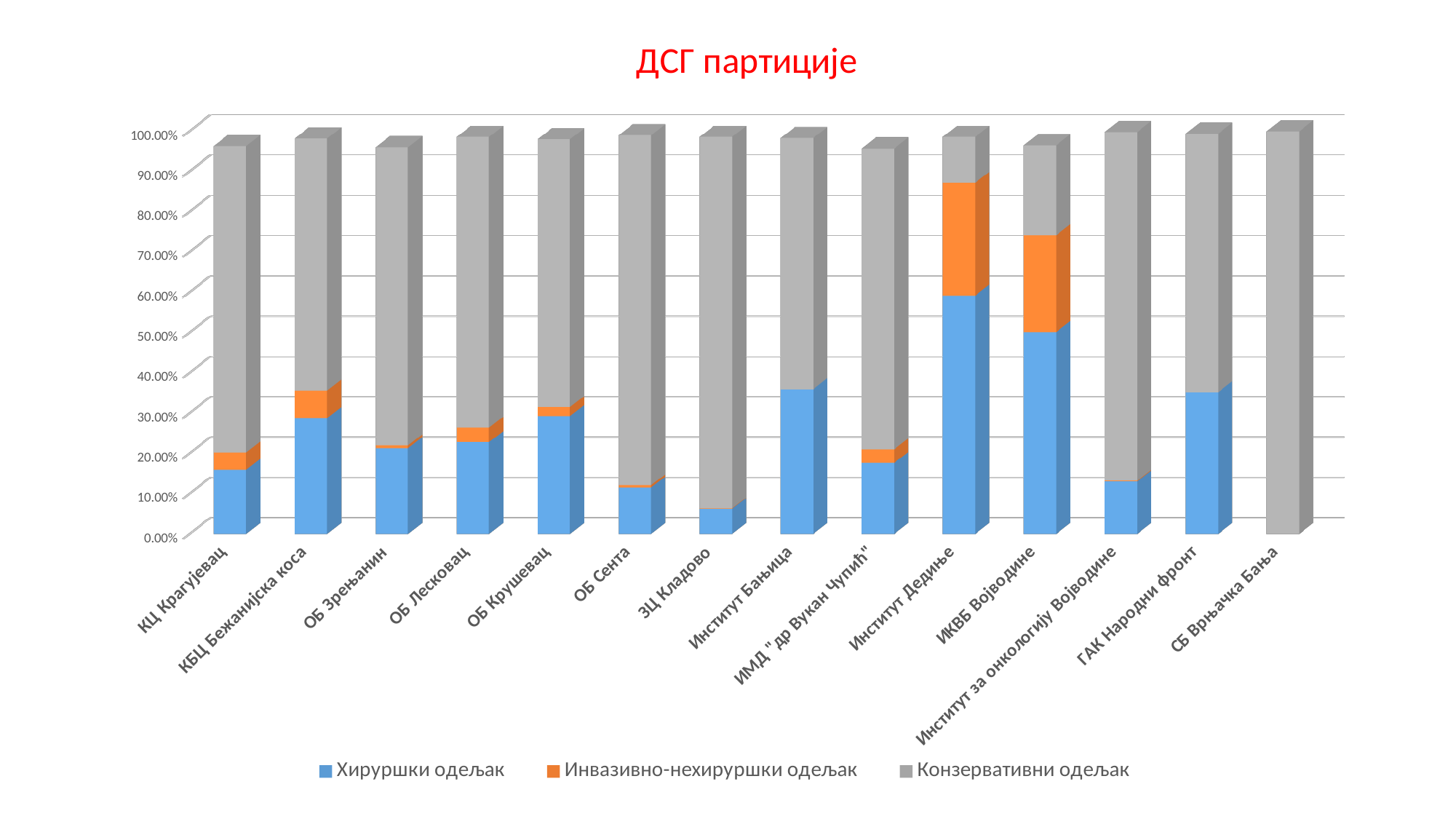
What kind of chart is shown on the slide? Stacked bar chart Which has a larger Хируршки одељак value, Институт Бањица or ОБ Сента? Институт Бањица How many series does the legend list? 3 How many institutions (categories) are shown on the x axis? 14 Which has a larger Хируршки одељак value, ГАК Народни фронт or ЗЦ Кладово? ГАК Народни фронт Which institution has the highest value for Хируршки одељак? Институт Дедиње Is the Хируршки одељак value for Институт Бањица greater or less than 30.00%? greater Is the Хируршки одељак value for ЗЦ Кладово greater or less than 10.00%? less Which series is shown in orange in the legend? Инвазивно-нехируршки одељак What is the title of the chart? ДСГ партиције Is the Хируршки одељак value for Институт Дедиње greater or less than 50.00%? greater Which institution has the lowest value for Хируршки одељак? СБ Врњачка Бања